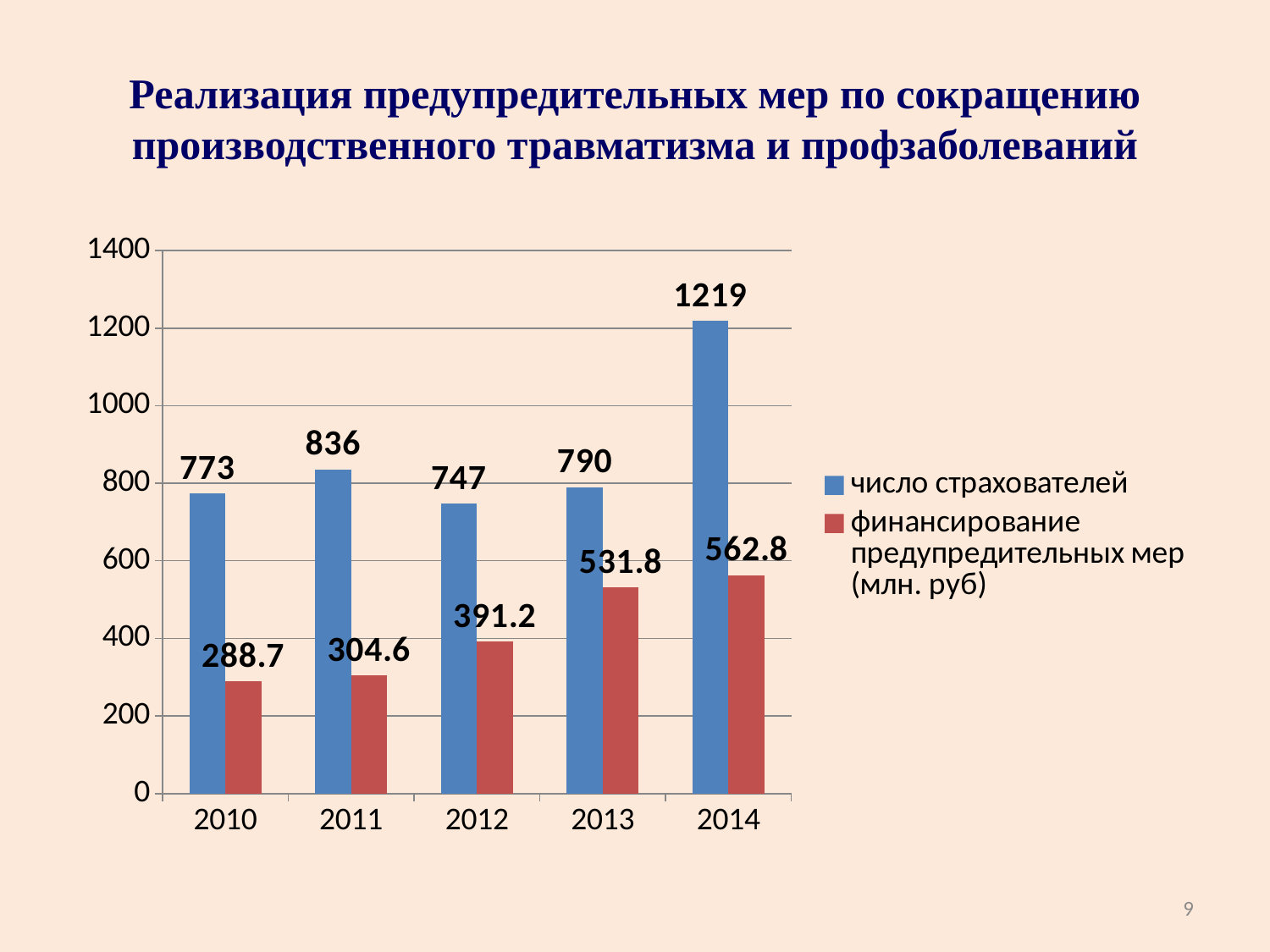
Does the "финансирование предупредительных мер (млн. руб)" series rise or fall from 2010 to 2014? rise What colour are the bars for "число страхователей"? blue Which year has the lowest value for "финансирование предупредительных мер (млн. руб)"? 2010 Which is larger: "финансирование предупредительных мер (млн. руб)" in 2013 or in 2014? 2014 How many series does the legend list? 2 What kind of chart is shown on the slide? bar chart What is the value of "число страхователей" for 2014? 1219 What is the difference between the "число страхователей" values for 2014 and 2013? 429 What is the value of "число страхователей" for 2010? 773 Which year has the highest value for "число страхователей"? 2014 How many years are shown on the x axis? 5 What is the value of "финансирование предупредительных мер (млн. руб)" for 2012? 391.2